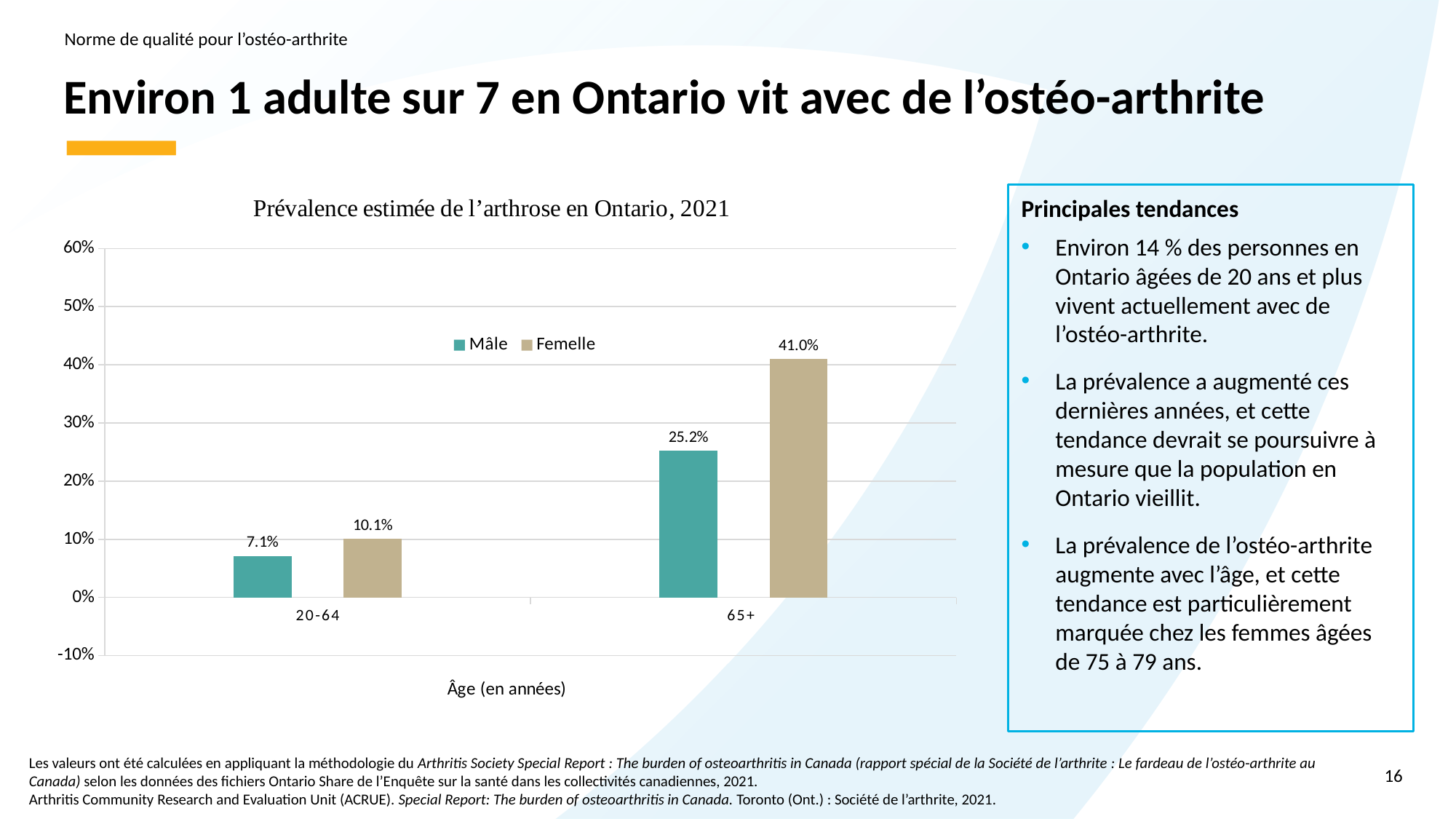
What is the prevalence for Femelle in the 65+ age group? 41.0% What is the prevalence for Mâle in the 20-64 age group? 7.1% What is the difference between the Femelle and Mâle values in the 65+ age group? 15.8% How many series does the legend list? 2 What is the prevalence for Mâle in the 65+ age group? 25.2% In the 20-64 age group, which is larger, the Mâle or the Femelle value? Femelle What kind of chart is shown on the slide? Bar chart What is the title of the chart? Prévalence estimée de l'arthrose en Ontario, 2021 What is the prevalence for Femelle in the 20-64 age group? 10.1% Which age group and series has the lowest prevalence? Mâle, 20-64 Which age group and series has the highest prevalence? Femelle, 65+ How many age groups are shown on the x axis? 2